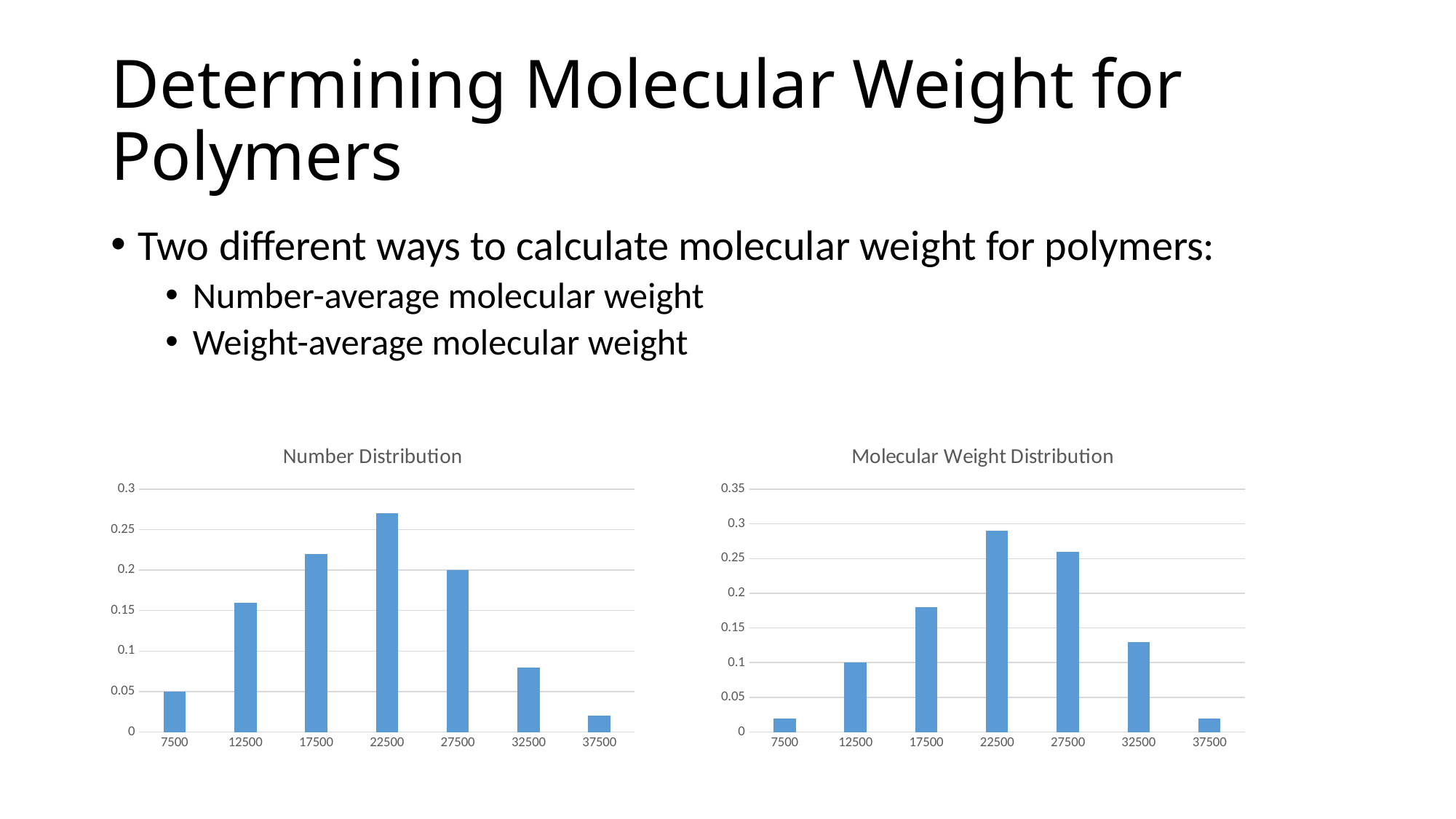
On the Number Distribution chart, which category has the lowest value? 37500 How many categories are shown on the x axis of the Molecular Weight Distribution chart? 7 What kind of chart is the Number Distribution chart? Bar chart On the Molecular Weight Distribution chart, which category has the highest value? 22500 On the Molecular Weight Distribution chart, is the value for 32500 greater or less than 0.1? greater On the Number Distribution chart, is the value for 12500 greater or less than 0.15? greater On the Number Distribution chart, which is larger, the value for 22500 or the value for 27500? 22500 On the Number Distribution chart, what is the value for 27500? 0.2 On the Number Distribution chart, what is the value for 7500? 0.05 On the Molecular Weight Distribution chart, is the value for 17500 greater or less than 0.2? less On the Molecular Weight Distribution chart, what is the value for 12500? 0.1 On the Number Distribution chart, which category has the highest value? 22500